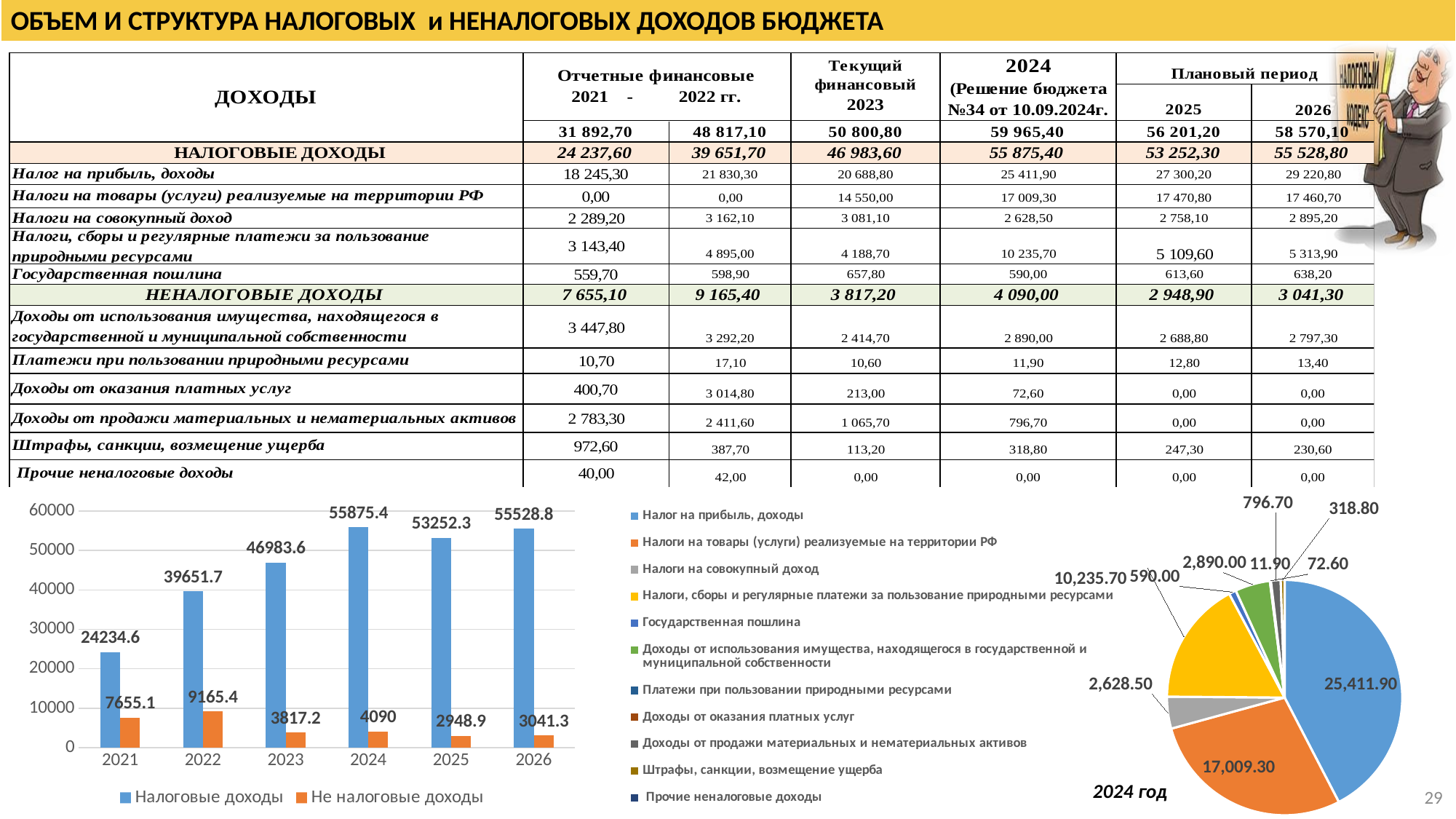
In the pie chart at the bottom right, what is the value of the slice for Налоги, сборы и регулярные платежи за пользование природными ресурсами (yellow)? 10,235.70 In the bar chart at the bottom left, what is the value of Налоговые доходы for 2024? 55875.4 In the pie chart at the bottom right, what is the value of the largest slice? 25,411.90 In the pie chart at the bottom right, how many entries does the legend list? 11 In the bar chart at the bottom left, is the value of Не налоговые доходы for 2022 larger than for 2023? Yes In the bar chart at the bottom left, what is the value of Не налоговые доходы for 2022? 9165.4 What kind of chart is shown at the bottom left of the slide? Bar chart In the bar chart at the bottom left, which year has the lowest value of Не налоговые доходы? 2025 In the bar chart at the bottom left, how many years are shown on the x axis? 6 In the bar chart at the bottom left, how many series does the legend list? 2 In the bar chart at the bottom left, what is the difference between Налоговые доходы and Не налоговые доходы in 2021? 16579.5 In the bar chart at the bottom left, which year has the highest value of Налоговые доходы? 2024